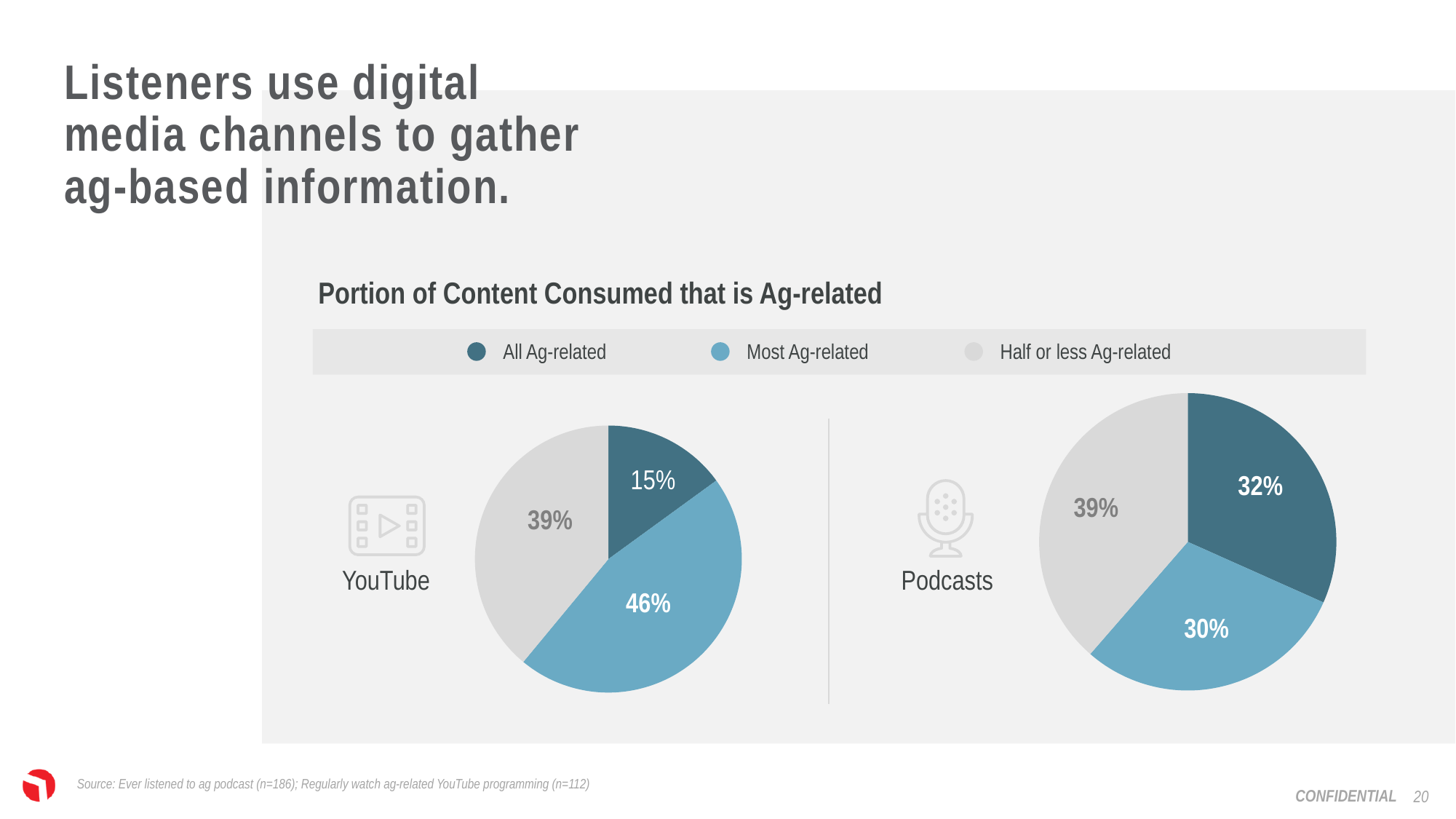
In the YouTube pie chart, what share is 'All Ag-related'? 15% In the Podcasts pie chart, what share of content consumed is 'All Ag-related'? 32% In the YouTube pie chart, which category has the largest share? Most Ag-related In the YouTube pie chart, which category has the smallest share? All Ag-related What type of chart is used to show the portion of content consumed that is Ag-related? Pie chart What is the difference between the 'All Ag-related' share for Podcasts and for YouTube? 17 percentage points In the YouTube pie chart, what share of content consumed is 'Most Ag-related'? 46% In the Podcasts pie chart, which category has the smallest share? Most Ag-related What is the title of the chart section containing the two pie charts? Portion of Content Consumed that is Ag-related In the Podcasts pie chart, what share is 'Half or less Ag-related'? 39% Which is larger: the 'Most Ag-related' share for YouTube or for Podcasts? YouTube How many categories does the legend list for the pie charts? 3